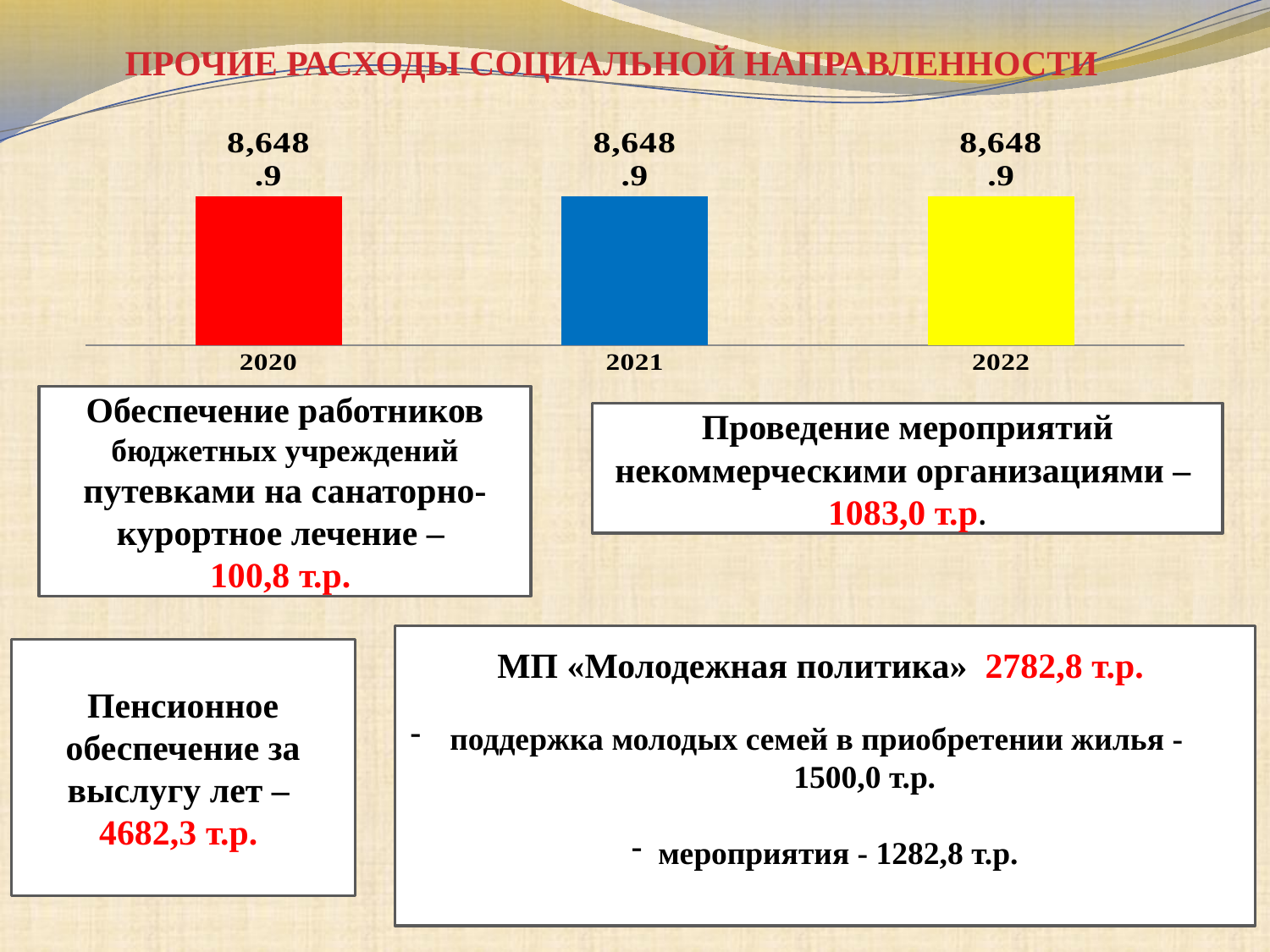
What kind of chart is shown on the slide? bar chart What colour is the bar for 2021? blue What is the value shown for 2022? 8,648.9 What is the value shown for 2021? 8,648.9 How many bars are plotted in the chart? 3 Do the values rise, fall or stay the same from 2020 to 2022? stay the same Which is larger, the value for 2020 or the value for 2022? they are equal What is the value shown for 2020? 8,648.9 What is the difference between the values for 2021 and 2020? 0 Which years are shown on the x axis of the chart? 2020, 2021, 2022